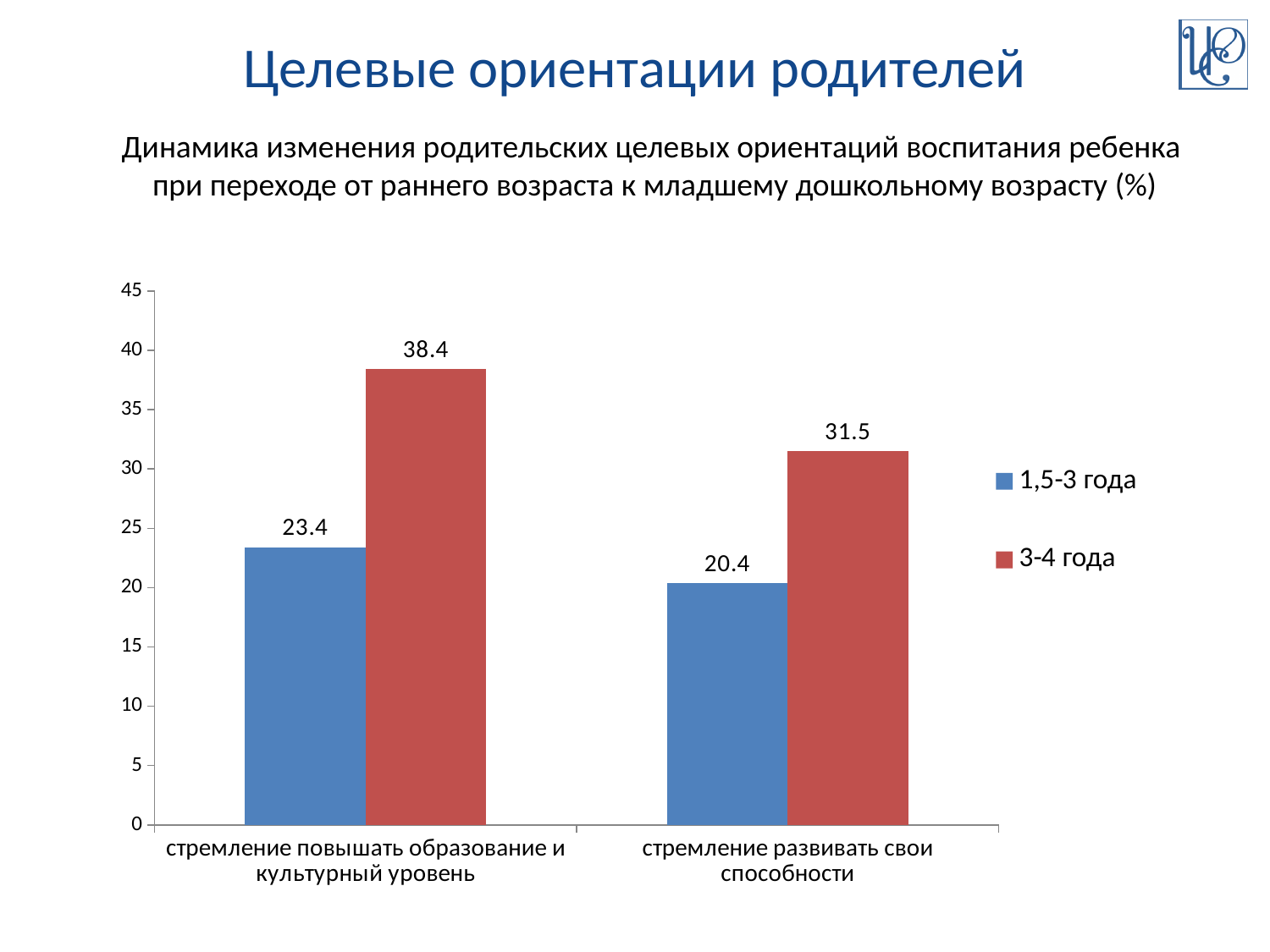
Which category has the lowest value for the '1,5-3 года' series? стремление развивать свои способности How many series does the legend list? 2 What is the value for '1,5-3 года' in the category 'стремление повышать образование и культурный уровень'? 23.4 Which category has the highest value for the '3-4 года' series? стремление повышать образование и культурный уровень What is the value for '3-4 года' in the category 'стремление развивать свои способности'? 31.5 What is the value for '3-4 года' in the category 'стремление повышать образование и культурный уровень'? 38.4 Which is larger for 'стремление развивать свои способности': the value for '1,5-3 года' or for '3-4 года'? 3-4 года What is the difference between the '3-4 года' and '1,5-3 года' values for 'стремление развивать свои способности'? 11.1 How many categories are shown on the x axis? 2 What is the value for '1,5-3 года' in the category 'стремление развивать свои способности'? 20.4 What kind of chart is shown on the slide? bar chart What is the difference between the '3-4 года' and '1,5-3 года' values for 'стремление повышать образование и культурный уровень'? 15